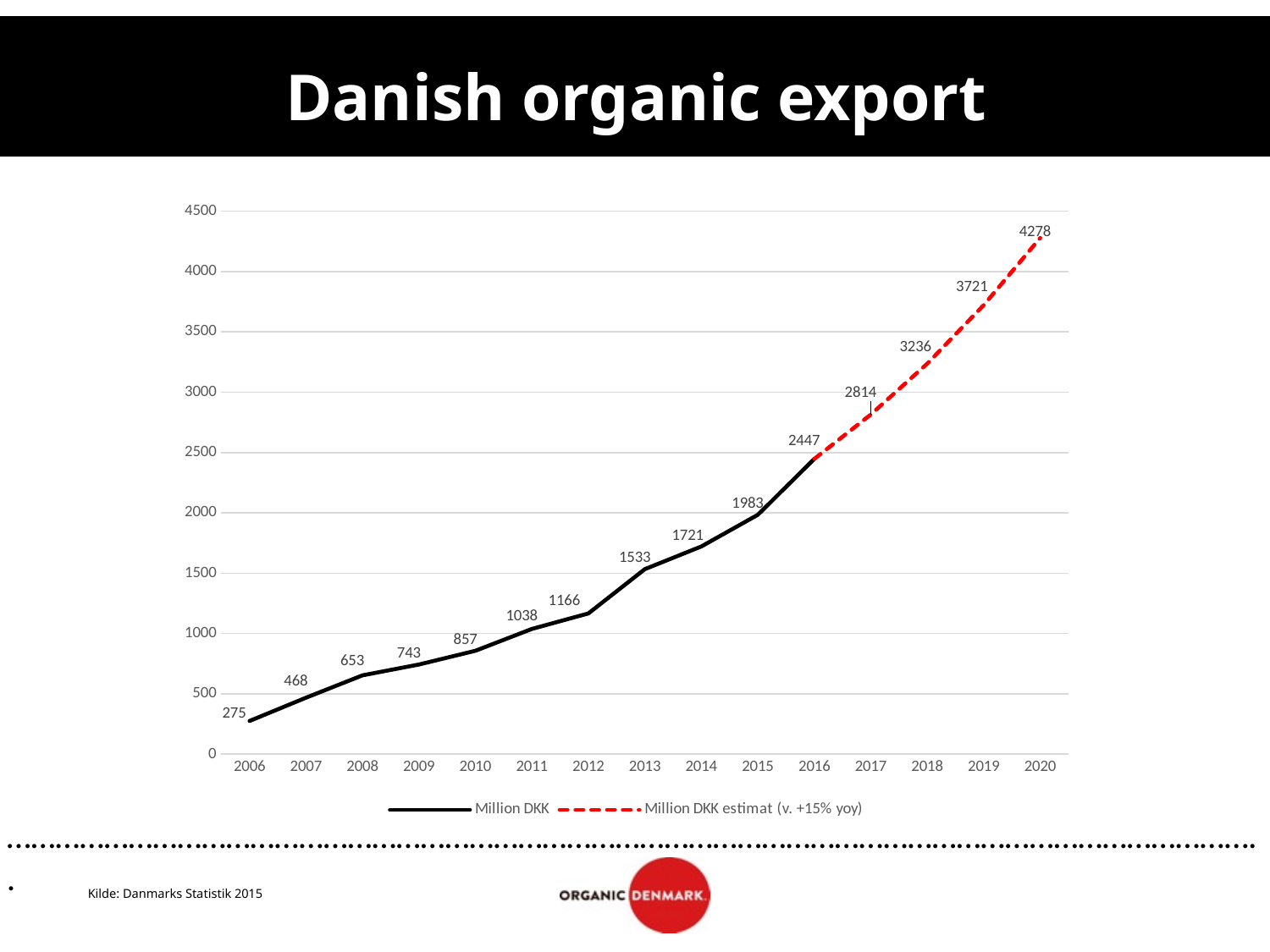
Which is larger, the value for 2010 or the value for 2011? 2011 Which year has the lowest value on the chart? 2006 How many series does the legend list? 2 What is the value for 2006? 275 What is the value for 2013? 1533 What is the value for 2016? 2447 What kind of chart is shown on the slide? Line chart What is the difference between the values for 2016 and 2015? 464 Do the values rise or fall from 2006 to 2020? Rise How many years are shown on the x axis? 15 What is the estimated value for 2020? 4278 Which year has the highest value on the chart? 2020